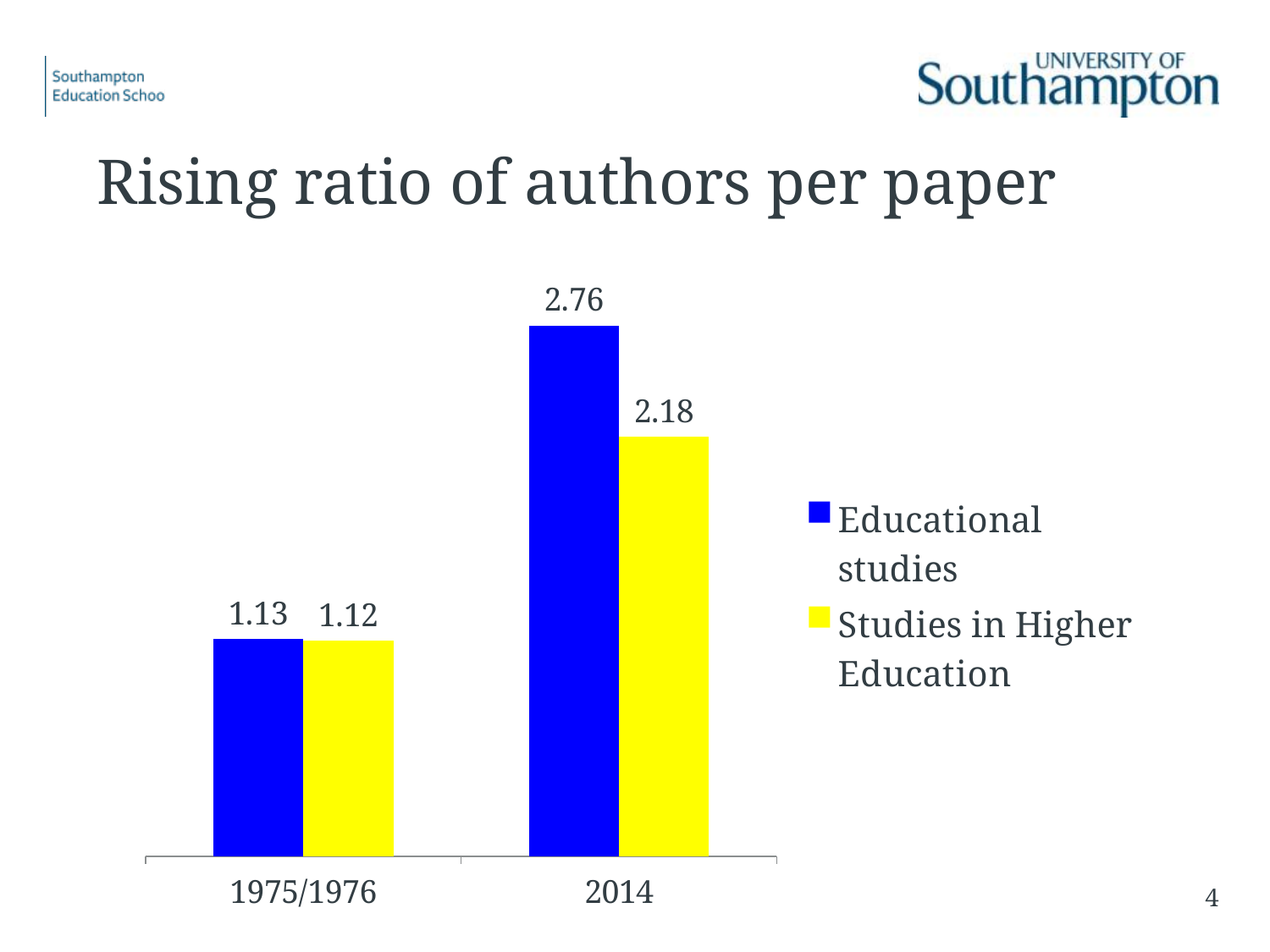
Which series has the highest value in 2014? Educational studies Which is larger in 2014: Educational studies or Studies in Higher Education? Educational studies Do the values for Studies in Higher Education rise or fall from 1975/1976 to 2014? Rise What is the value for Educational studies in 2014? 2.76 What is the difference between the Educational studies values for 2014 and 1975/1976? 1.63 What is the difference between Educational studies and Studies in Higher Education in 2014? 0.58 How many series does the legend list? 2 What is the value for Educational studies in 1975/1976? 1.13 What is the value for Studies in Higher Education in 2014? 2.18 What kind of chart is shown on the slide? Bar chart What is the value for Studies in Higher Education in 1975/1976? 1.12 How many categories are shown on the x axis? 2